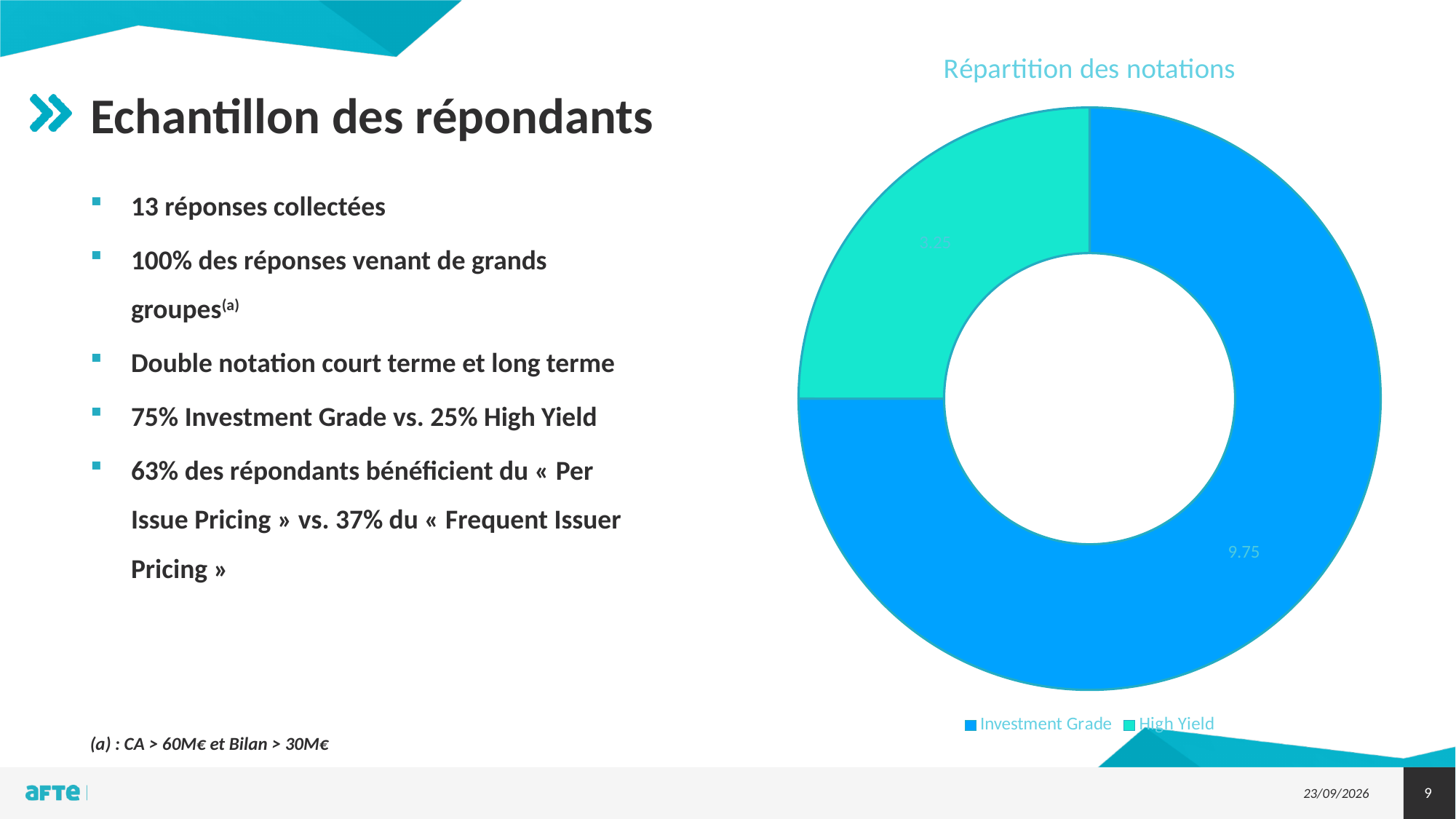
How many categories does the legend of the chart list? 2 Which category has the largest slice in the chart? Investment Grade What colour is the High Yield slice in the chart? Teal (turquoise) What is the value shown for High Yield in the chart? 3.25 What is the value shown for Investment Grade in the chart? 9.75 Which is larger in the chart, Investment Grade or High Yield? Investment Grade What is the difference between the Investment Grade value and the High Yield value in the chart? 6.5 Which category has the smallest slice in the chart? High Yield What is the title of the chart on the slide? Répartition des notations What is the total of the two values shown in the chart? 13 What kind of chart is shown under the title "Répartition des notations"? Doughnut chart What share of the chart does the Investment Grade slice represent? 75%